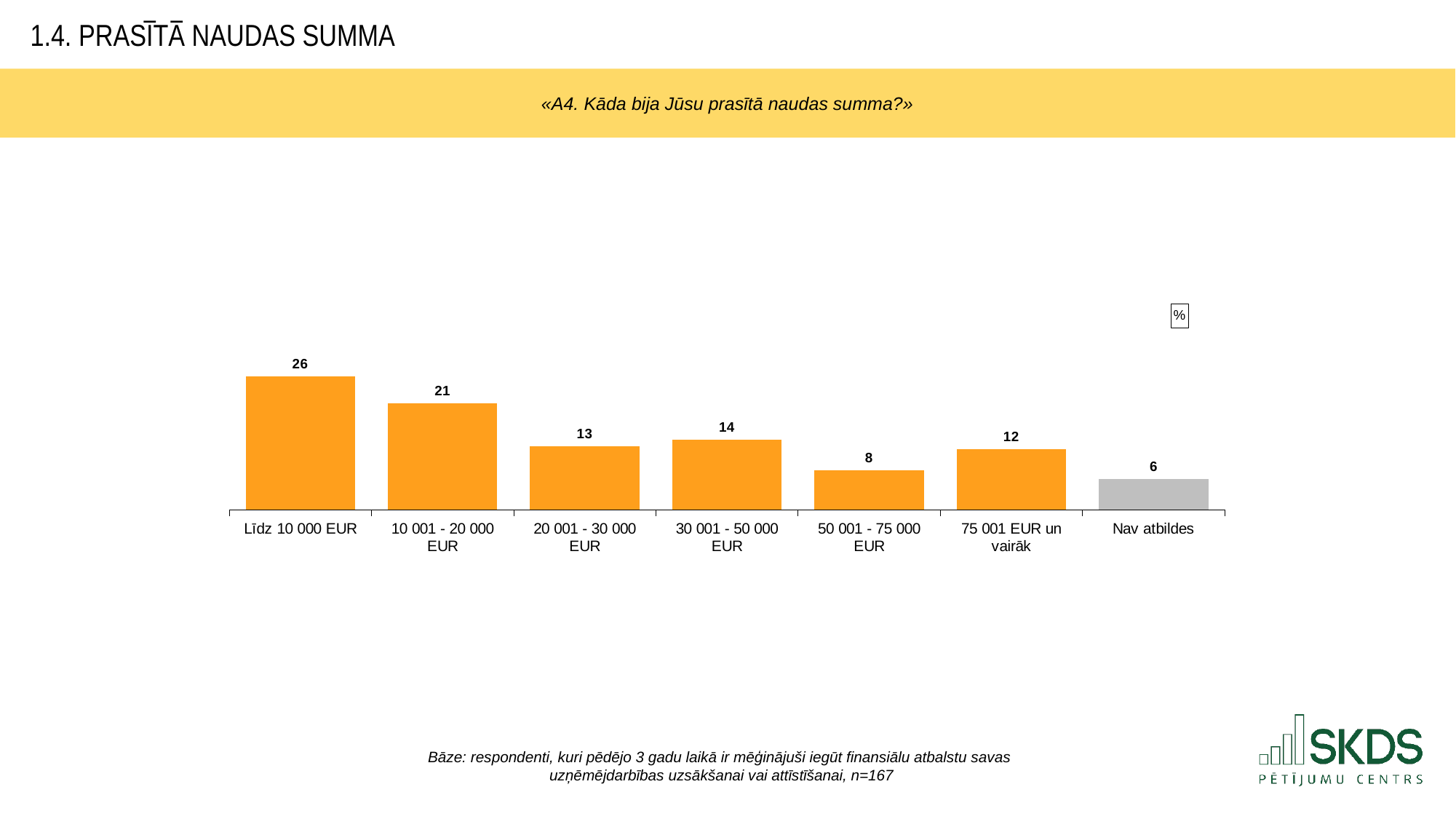
Which category has the lowest value? Nav atbildes What is the value for "Nav atbildes"? 6 What is the value for "Līdz 10 000 EUR"? 26 What is the value for "50 001 - 75 000 EUR"? 8 What is the difference between the values for "Līdz 10 000 EUR" and "10 001 - 20 000 EUR"? 5 What unit is indicated in the small box at the top right of the chart? % What is the value for "75 001 EUR un vairāk"? 12 What kind of chart is shown on the slide? Bar chart How many categories are shown on the x axis? 7 What is the difference between the values for "75 001 EUR un vairāk" and "50 001 - 75 000 EUR"? 4 Which category has the highest value? Līdz 10 000 EUR Which is larger, the value for "20 001 - 30 000 EUR" or "30 001 - 50 000 EUR"? 30 001 - 50 000 EUR